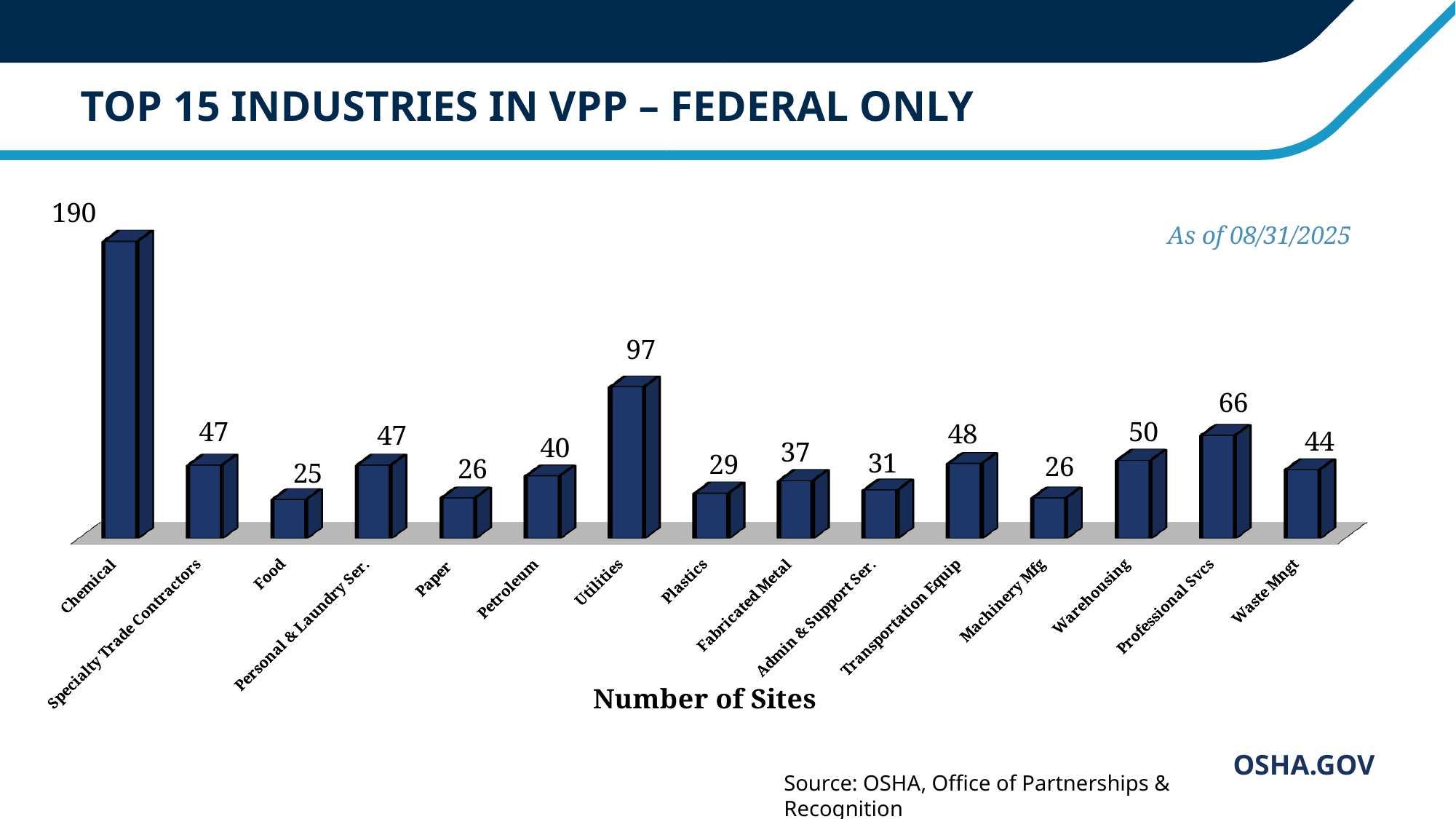
What is the number of sites for Utilities? 97 What is the difference between Warehousing and Transportation Equip? 2 Which industry has the lowest number of sites? Food How many sites does the Chemical industry have? 190 How many sites are shown for Waste Mngt? 44 Which industry has the highest number of sites? Chemical What is the difference in number of sites between Chemical and Utilities? 93 What type of chart is shown on the slide? Bar chart What is the title of the chart on the slide? TOP 15 INDUSTRIES IN VPP – FEDERAL ONLY How many industries are shown in the chart? 15 Which has more sites, Petroleum or Fabricated Metal? Petroleum What is the value shown for Professional Svcs? 66